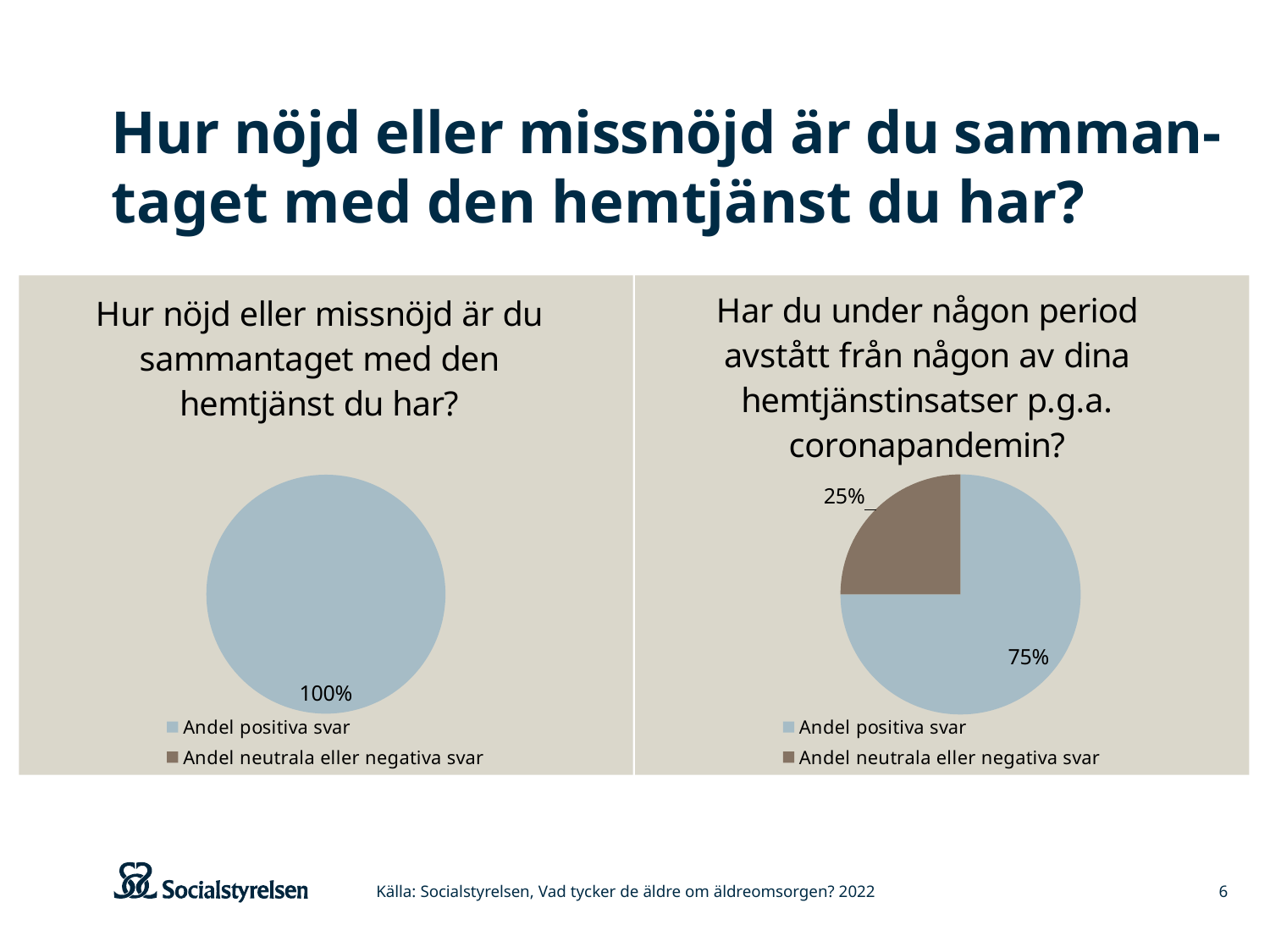
In the right chart, what is the difference between the 'Andel positiva svar' share and the 'Andel neutrala eller negativa svar' share? 50% In the right chart, which is larger: 'Andel positiva svar' or 'Andel neutrala eller negativa svar'? Andel positiva svar In the right chart, what colour is the 'Andel neutrala eller negativa svar' slice? Brown What type of chart is used on the left side of the slide? Pie chart In the right chart, what share of responses is 'Andel positiva svar'? 75% How many series does the legend of the right chart list? 2 How many visible slices does the right pie chart have? 2 In the right chart, which slice is the largest? Andel positiva svar In the right chart, what share of responses is 'Andel neutrala eller negativa svar'? 25% What is the title of the right chart? Har du under någon period avstått från någon av dina hemtjänstinsatser p.g.a. coronapandemin? In the left chart, what share of responses is 'Andel positiva svar'? 100% In the right chart, which slice is the smallest? Andel neutrala eller negativa svar